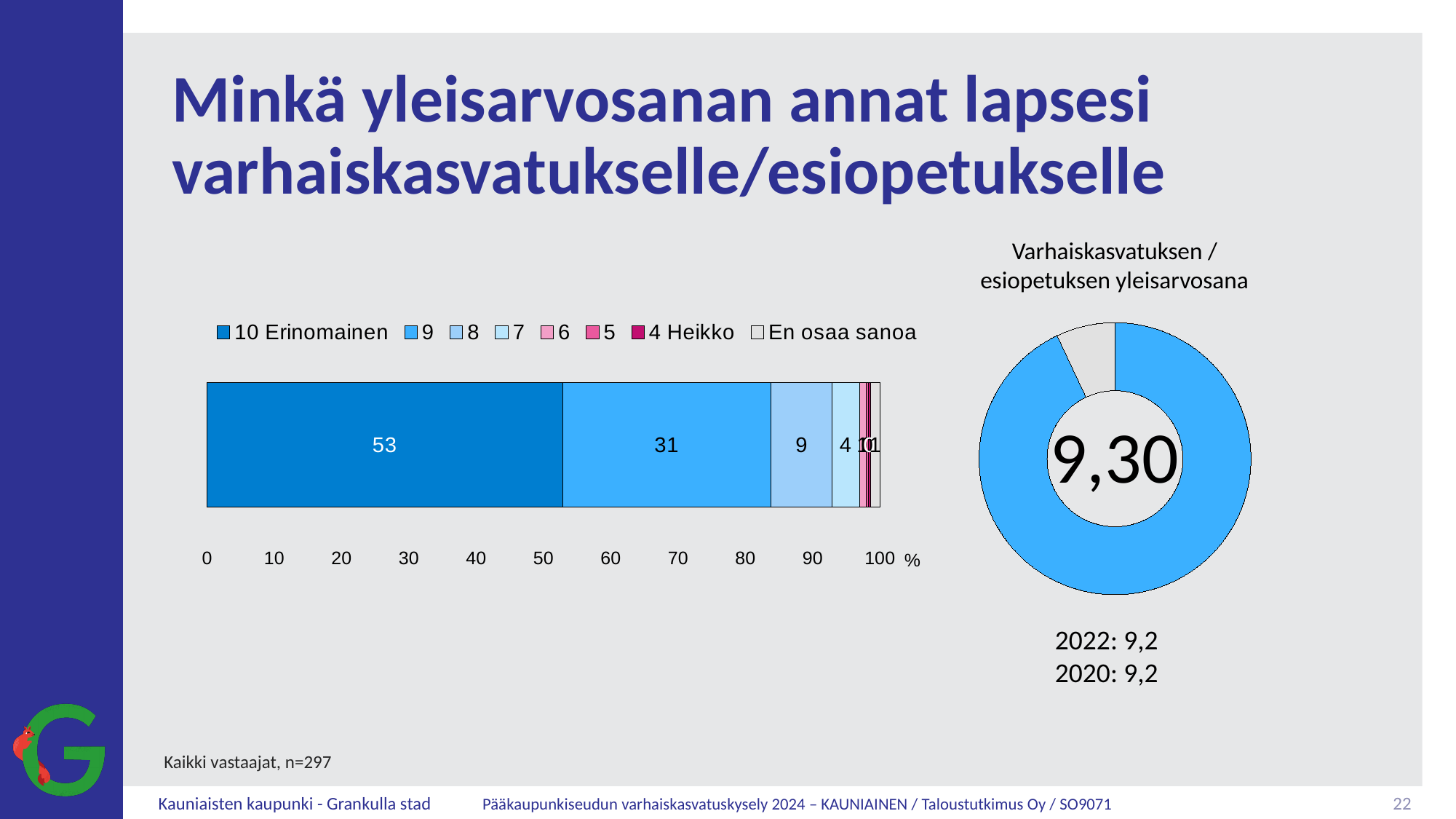
In the stacked bar chart, what percentage of respondents gave the grade 7? 4 What kind of chart is the chart on the left of the slide? Stacked bar chart What is the first legend entry of the stacked bar chart? 10 Erinomainen In the stacked bar chart, what is the difference in percentage points between the share for grade 10 Erinomainen and the share for grade 9? 22 In the stacked bar chart, which grade category has the largest share? 10 Erinomainen In the stacked bar chart, what percentage of respondents gave the grade 8? 9 What value is shown in the centre of the donut chart titled 'Varhaiskasvatuksen / esiopetuksen yleisarvosana'? 9,30 In the stacked bar chart, which is larger: the share for grade 9 or the share for grade 8? 9 In the stacked bar chart, what percentage of respondents gave the grade 9? 31 In the stacked bar chart, what percentage of respondents gave the grade 10 Erinomainen? 53 In the stacked bar chart, is the share for grade 10 Erinomainen greater or less than 50? greater How many series does the legend of the stacked bar chart list? 8